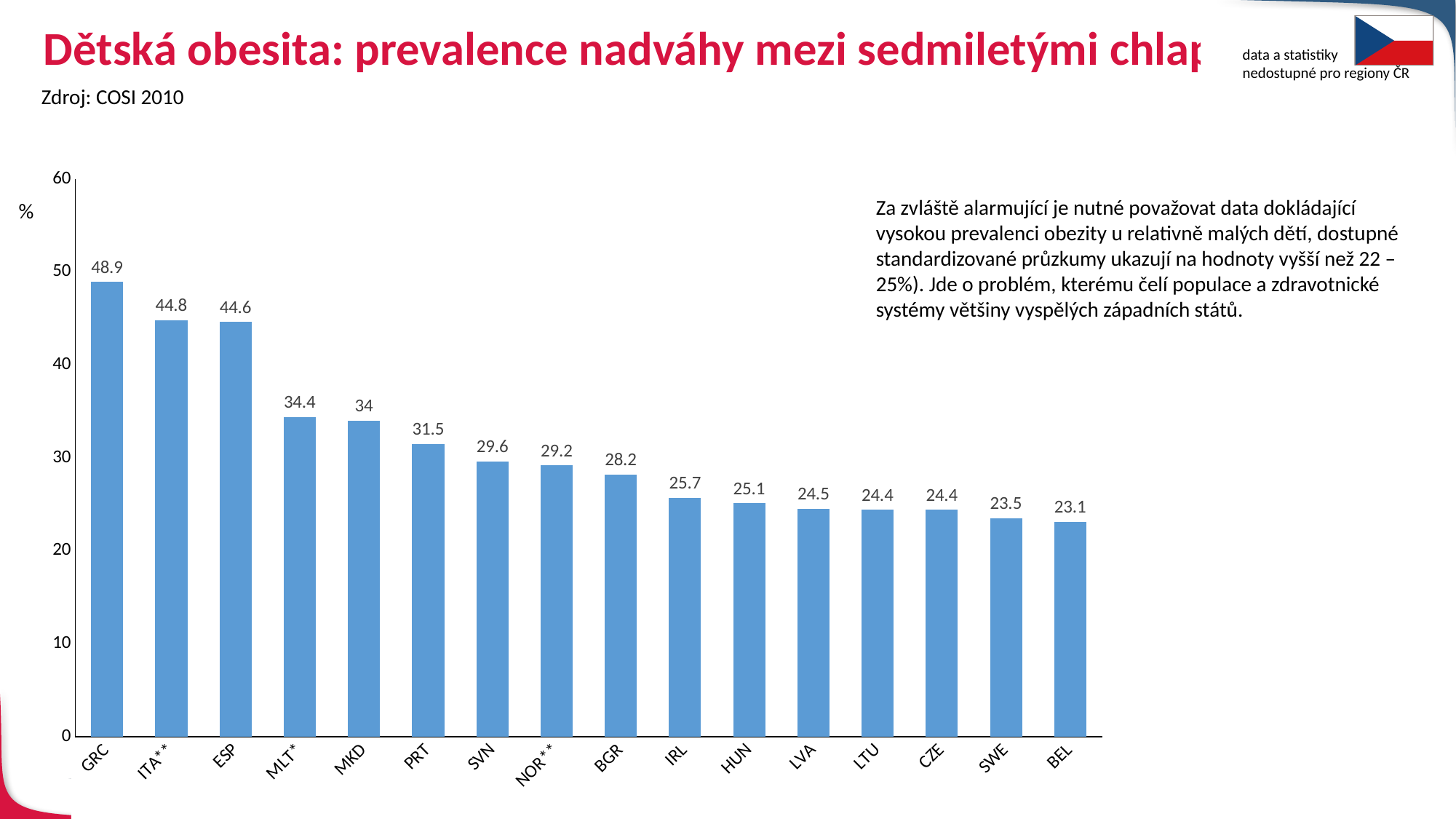
What is the value for GRC? 48.9 Is the value for IRL greater or less than 30? less What is the difference between the values for MLT* and MKD? 0.4 What kind of chart is shown on the slide? bar chart Which country has the highest value? GRC What is the difference between the values for GRC and BEL? 25.8 What is the value for PRT? 31.5 Which country has the lowest value? BEL Do the values rise or fall from left to right along the x axis? fall How many countries are shown on the chart? 16 Which is larger, the value for ESP or the value for SVN? ESP What is the value for CZE? 24.4